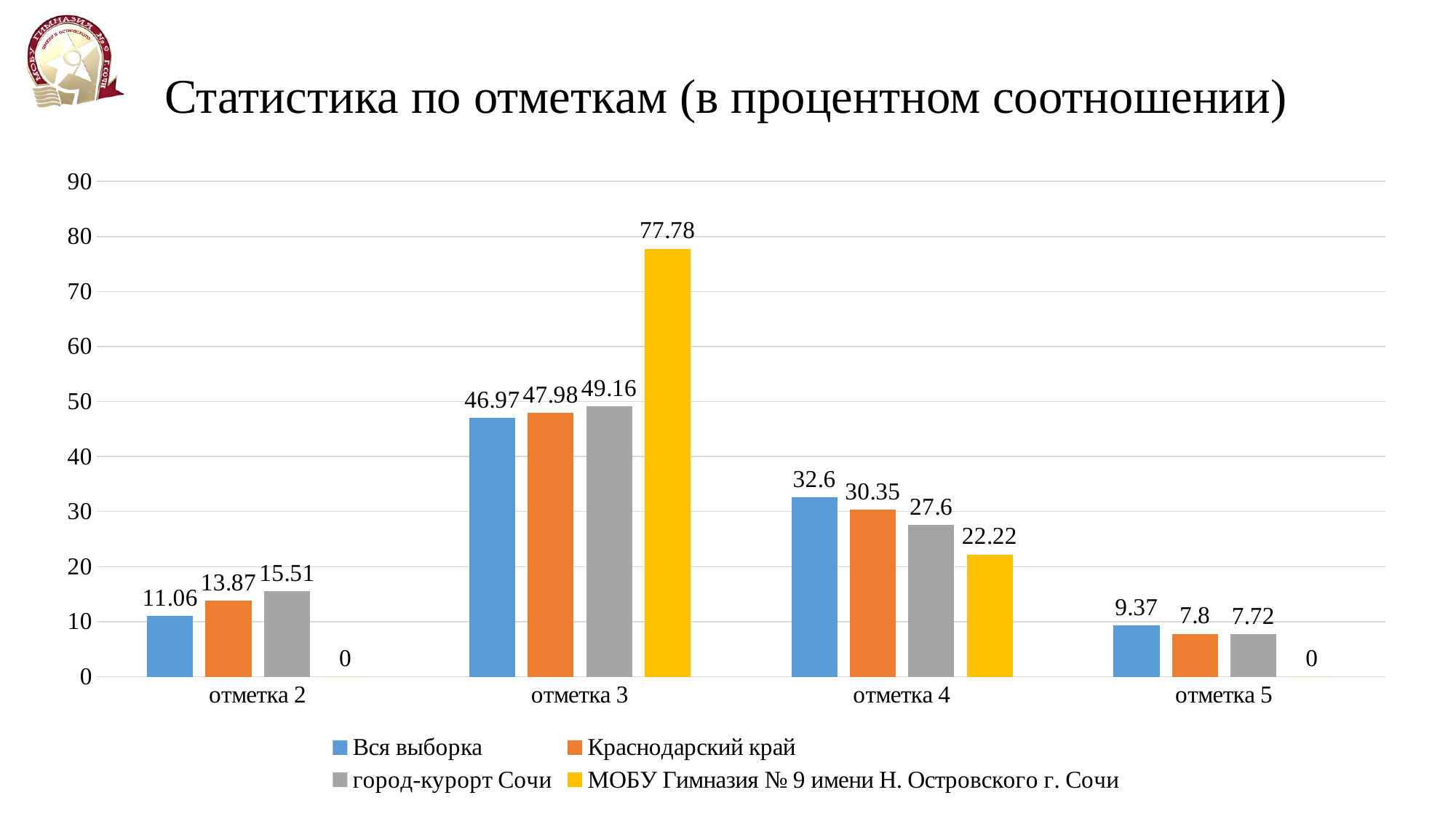
What kind of chart is shown on the slide? bar chart What is the value for МОБУ Гимназия № 9 имени Н. Островского г. Сочи at отметка 4? 22.22 What is the title of the chart? Статистика по отметкам (в процентном соотношении) Which is larger at отметка 4: Вся выборка or Краснодарский край? Вся выборка How many series does the legend list? 4 Which series has the highest value at отметка 3? МОБУ Гимназия № 9 имени Н. Островского г. Сочи What is the difference between the values for МОБУ Гимназия № 9 имени Н. Островского г. Сочи and Вся выборка at отметка 3? 30.81 What is the value for город-курорт Сочи at отметка 2? 15.51 How many categories are shown on the x axis? 4 What is the value for Краснодарский край at отметка 5? 7.8 What is the value for Вся выборка at отметка 3? 46.97 Which series has the lowest value at отметка 4? МОБУ Гимназия № 9 имени Н. Островского г. Сочи